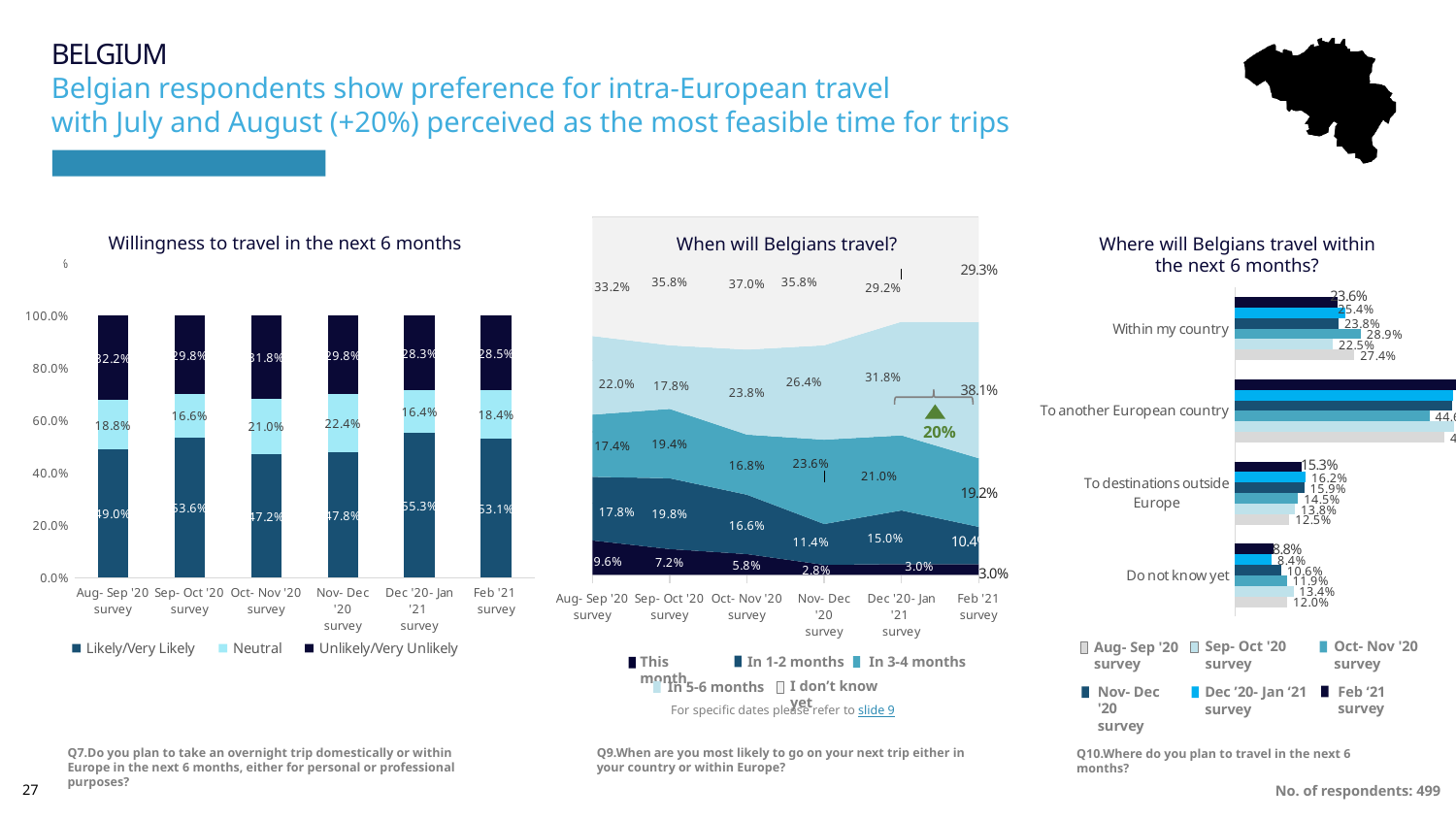
In the 'When will Belgians travel?' chart, which survey has the highest 'I don't know yet' value? Oct- Nov '20 survey In the 'Willingness to travel in the next 6 months' chart, what is the Likely/Very Likely value for the Dec '20- Jan '21 survey? 55.3% In the 'Where will Belgians travel within the next 6 months?' chart, how many series does the legend list? 6 In the 'When will Belgians travel?' chart, how many surveys are shown on the x axis? 6 In the 'Willingness to travel in the next 6 months' chart, what is the difference between the Likely/Very Likely values for the Sep- Oct '20 survey and the Oct- Nov '20 survey? 6.4% In the 'Willingness to travel in the next 6 months' chart, what is the Neutral value for the Nov- Dec '20 survey? 22.4% In the 'When will Belgians travel?' chart, what is the 'In 5-6 months' value for the Feb '21 survey? 38.1% In the 'When will Belgians travel?' chart, does the 'This month' value rise or fall from the Aug- Sep '20 survey to the Nov- Dec '20 survey? fall In the 'When will Belgians travel?' chart, what is the 'This month' value for the Aug- Sep '20 survey? 9.6% What kind of chart is 'Where will Belgians travel within the next 6 months?'? bar chart In the 'Willingness to travel in the next 6 months' chart, which survey has the highest Likely/Very Likely value? Dec '20- Jan '21 survey In the 'Willingness to travel in the next 6 months' chart, how many series does the legend list? 3